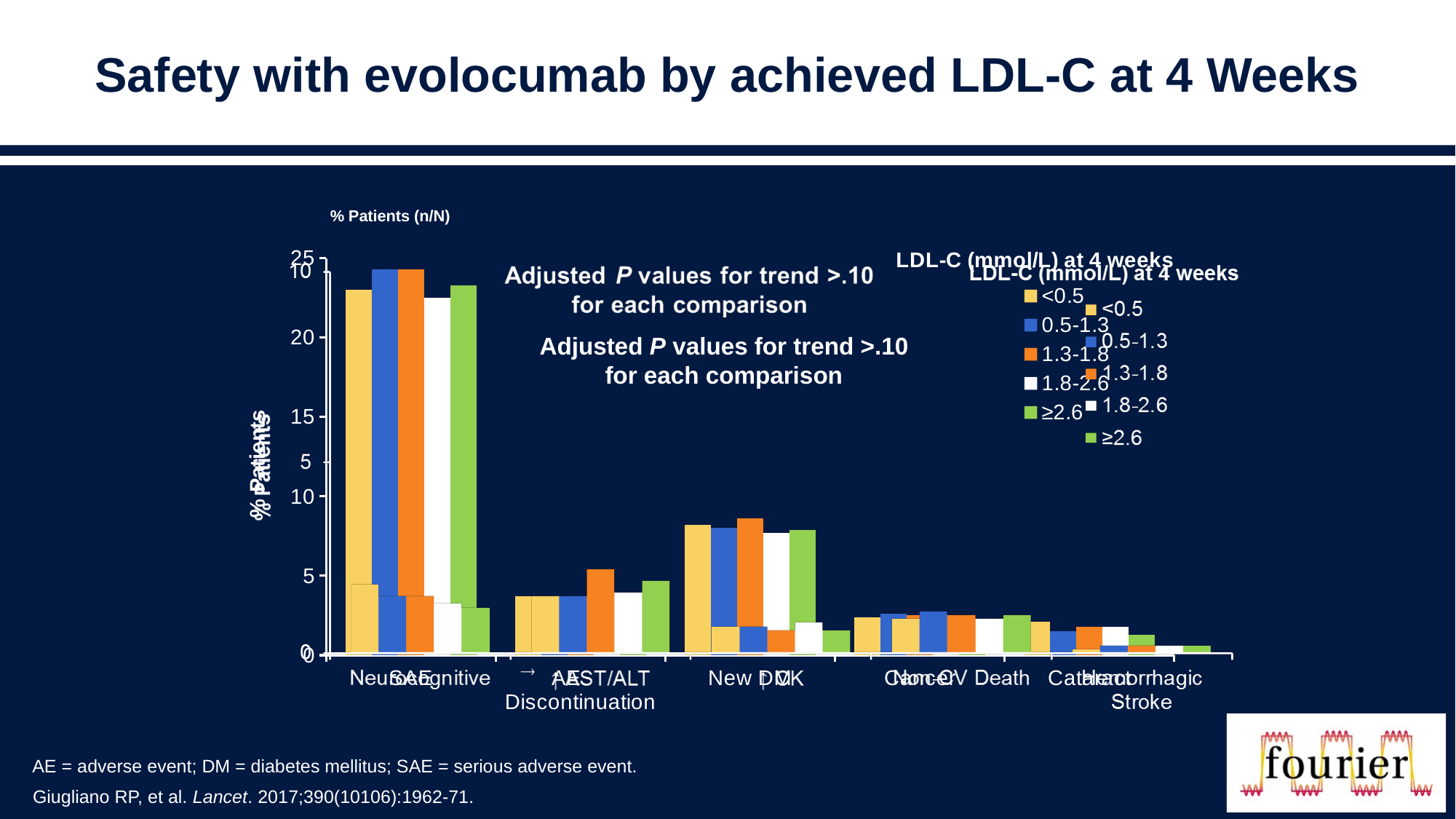
What is the last legend entry listed? ≥2.6 What is the title of the legend? LDL-C (mmol/L) at 4 weeks What kind of chart is shown on the slide? bar chart Which legend entry is shown in green? ≥2.6 How many series does the legend list? 5 What is the first legend entry listed? <0.5